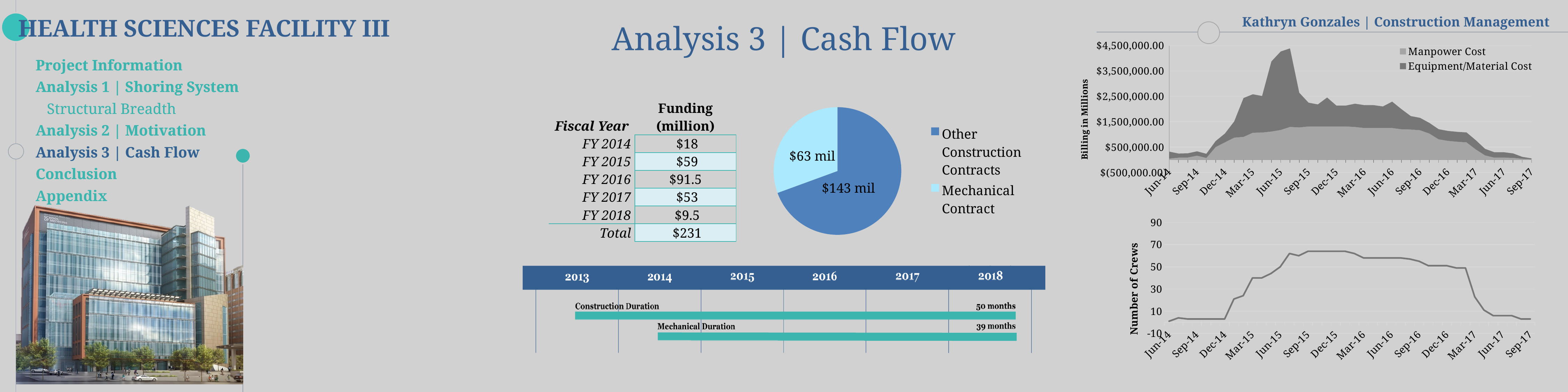
In the Billing in Millions chart, is the peak total billing around Jun-15 greater or less than $3,500,000.00? greater How many slices does the pie chart have? 2 How many series does the legend of the Billing in Millions chart list? 2 In the pie chart, what is the difference between Other Construction Contracts and Mechanical Contract? $80 mil In the pie chart, which slice is larger, Other Construction Contracts or Mechanical Contract? Other Construction Contracts What kind of chart is the top-right chart showing Billing in Millions? Area chart In the Number of Crews chart, is the value at Sep-15 greater or less than 50? greater In the pie chart, what is the value for Other Construction Contracts? $143 mil In the Billing in Millions chart, do the total values rise or fall from Jun-15 to Sep-17? fall What are the two series named in the legend of the Billing in Millions chart? Manpower Cost and Equipment/Material Cost In the pie chart, what is the value for Mechanical Contract? $63 mil What kind of chart is the bottom-right chart showing Number of Crews? Line chart